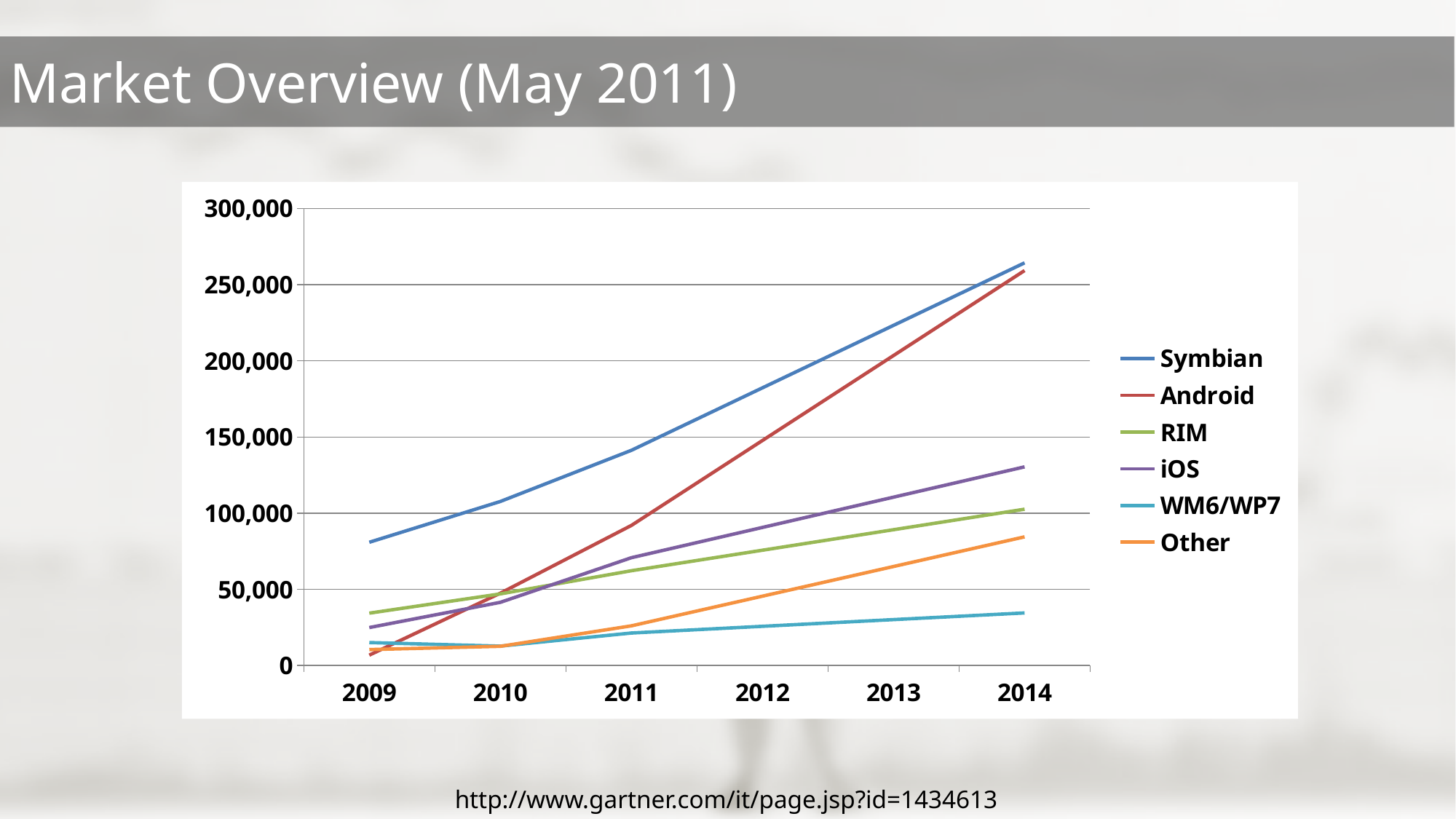
Which is larger in 2014, iOS or RIM? iOS Is the value for Symbian in 2009 greater or less than 100,000? less Is the value for Symbian in 2014 greater or less than 250,000? greater How many years are shown on the x axis? 6 Which series has the lowest value in 2014? WM6/WP7 Is the value for iOS in 2014 greater or less than 100,000? greater Does the Android line rise or fall from 2009 to 2014? rise How many series does the legend list? 6 Which series has the highest value in 2009? Symbian What kind of chart is shown on the slide? line chart What is the title of the slide containing the chart? Market Overview (May 2011)